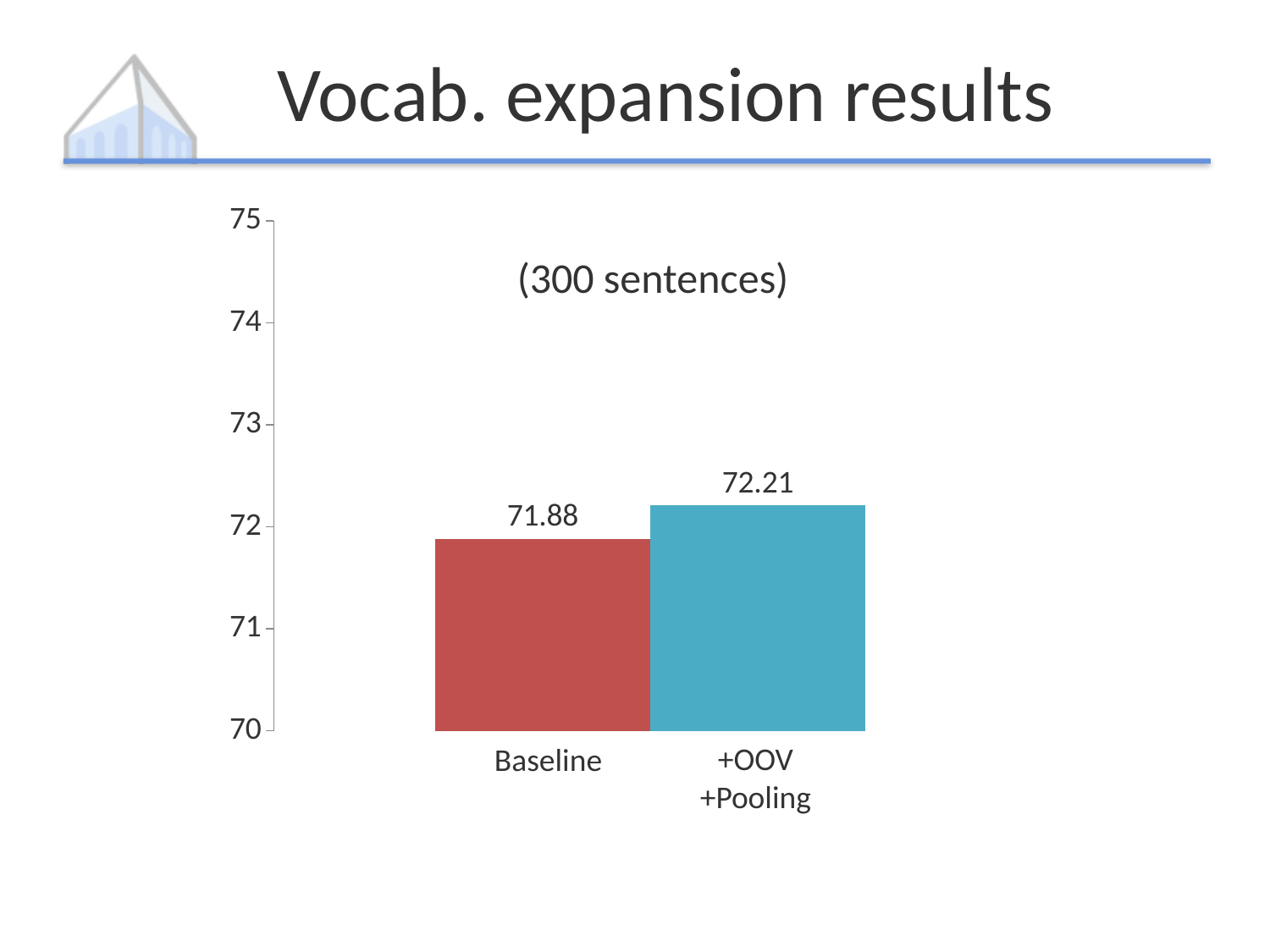
What is the value for +OOV +Pooling? 72.21 Which category has the lowest value? Baseline What colour is the bar for +OOV +Pooling? blue Which is larger, the value for Baseline or the value for +OOV +Pooling? +OOV +Pooling What is the title of the chart? (300 sentences) Is the value for Baseline greater or less than 72? less What is the difference between the +OOV +Pooling value and the Baseline value? 0.33 What is the value for Baseline? 71.88 Which category has the highest value? +OOV +Pooling What kind of chart is shown on the slide? bar chart How many categories are shown in the chart? 2 Is the value for +OOV +Pooling greater or less than 72? greater